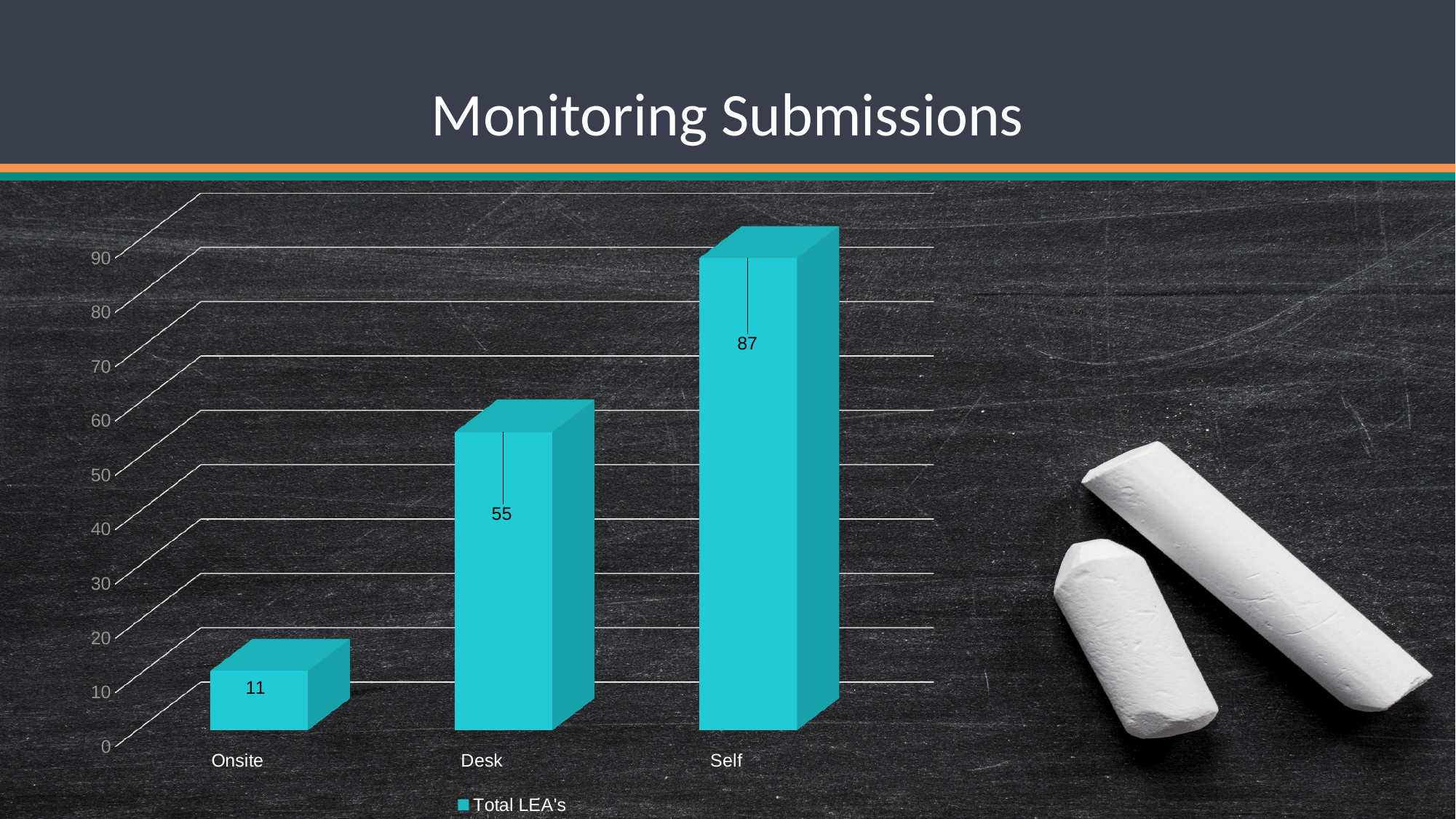
What series name does the legend show? Total LEA's Is the value for Desk greater or less than 50? greater What is the value for Onsite? 11 Which category has the lowest value? Onsite What kind of chart is shown on the slide? bar chart What is the value for Desk? 55 What is the difference between the values for Self and Desk? 32 What is the difference between the values for Desk and Onsite? 44 Which is larger, the value for Desk or the value for Onsite? Desk How many categories are shown on the x axis? 3 What is the value for Self? 87 Which category has the highest value? Self